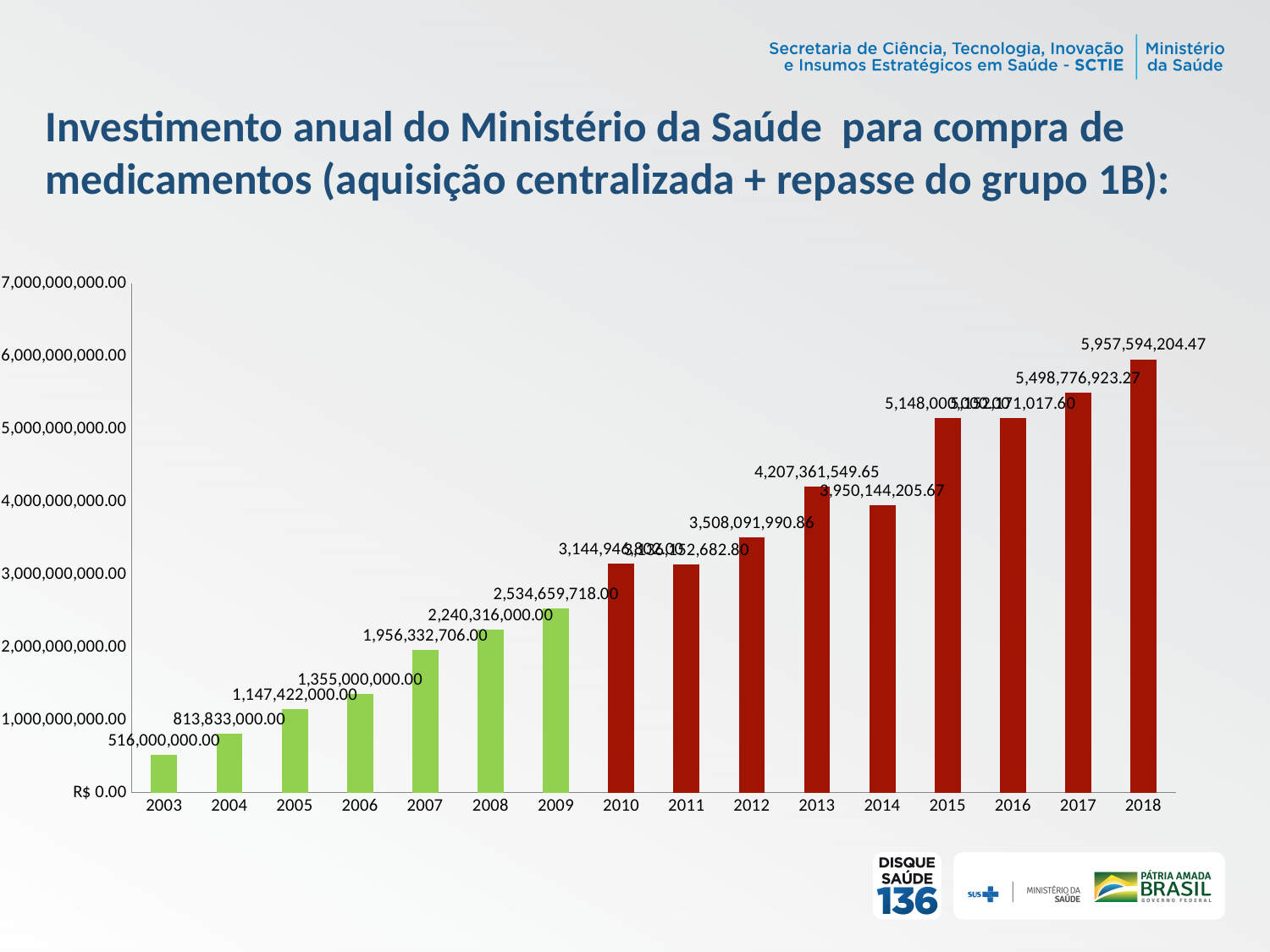
What is the value for 2003? 516,000,000.00 Which year has the lowest value? 2003 What kind of chart is shown on the slide? bar chart Which is larger, the value for 2013 or the value for 2014? 2013 Is the value for 2010 greater or less than 3,000,000,000.00? greater What is the value for 2007? 1,956,332,706.00 What is the difference between the values for 2018 and 2017? 458,817,281.20 What is the value for 2018? 5,957,594,204.47 How many years are shown on the x axis? 16 Which year has the highest value? 2018 What colour are the bars for the years 2003 to 2009? green What is the value for 2013? 4,207,361,549.65